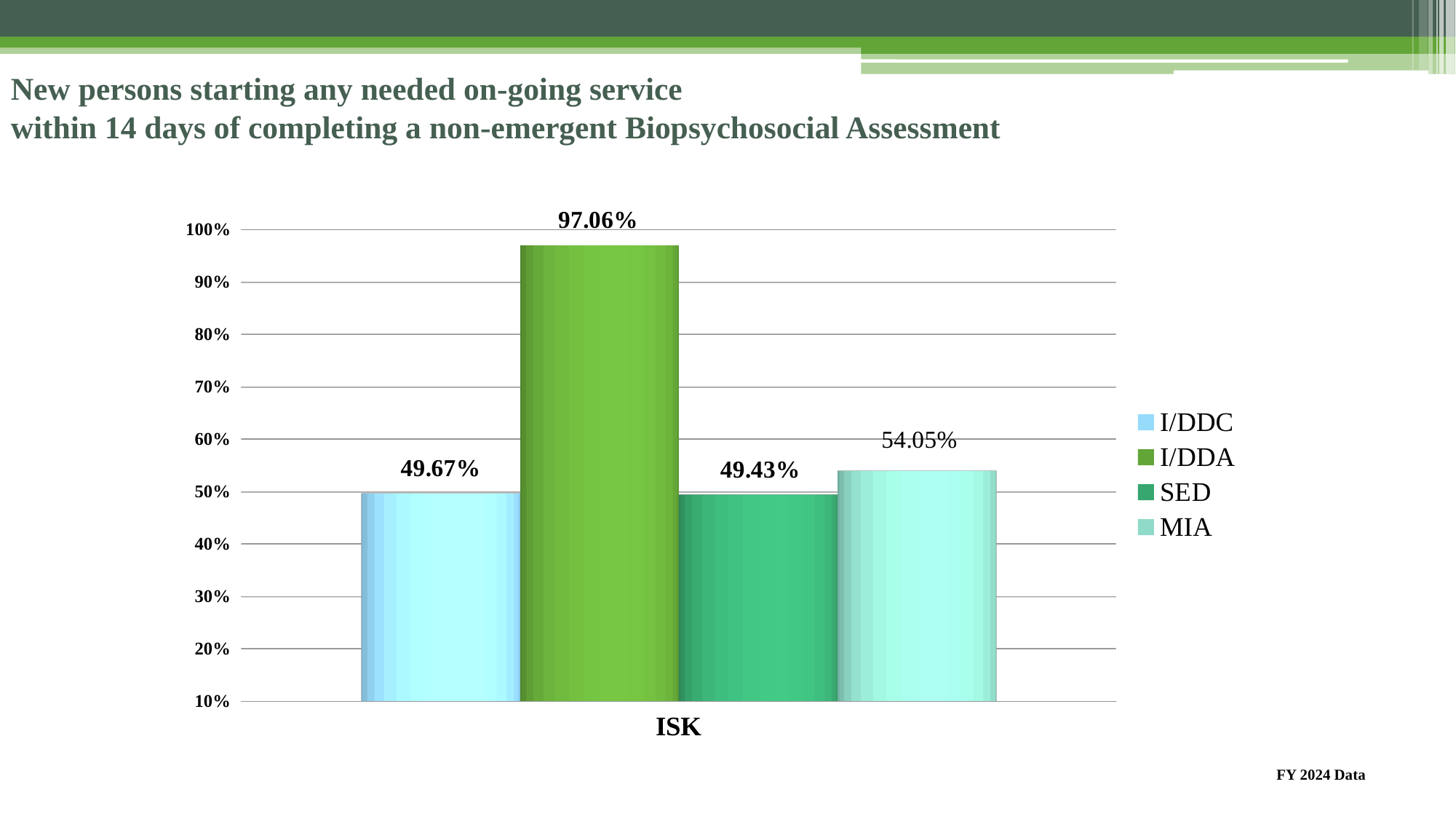
Which series has the lowest value? SED What is the value for I/DDC? 49.67% Which series has the highest value? I/DDA What is the difference between the I/DDC value and the SED value? 0.24% What is the difference between the I/DDA value and the MIA value? 43.01% What kind of chart is shown on the slide? Bar chart What is the category label shown on the x axis? ISK What is the value for MIA? 54.05% How many series does the legend list? 4 Which is larger, the value for MIA or the value for I/DDC? MIA What is the value for SED? 49.43% What is the value for I/DDA? 97.06%